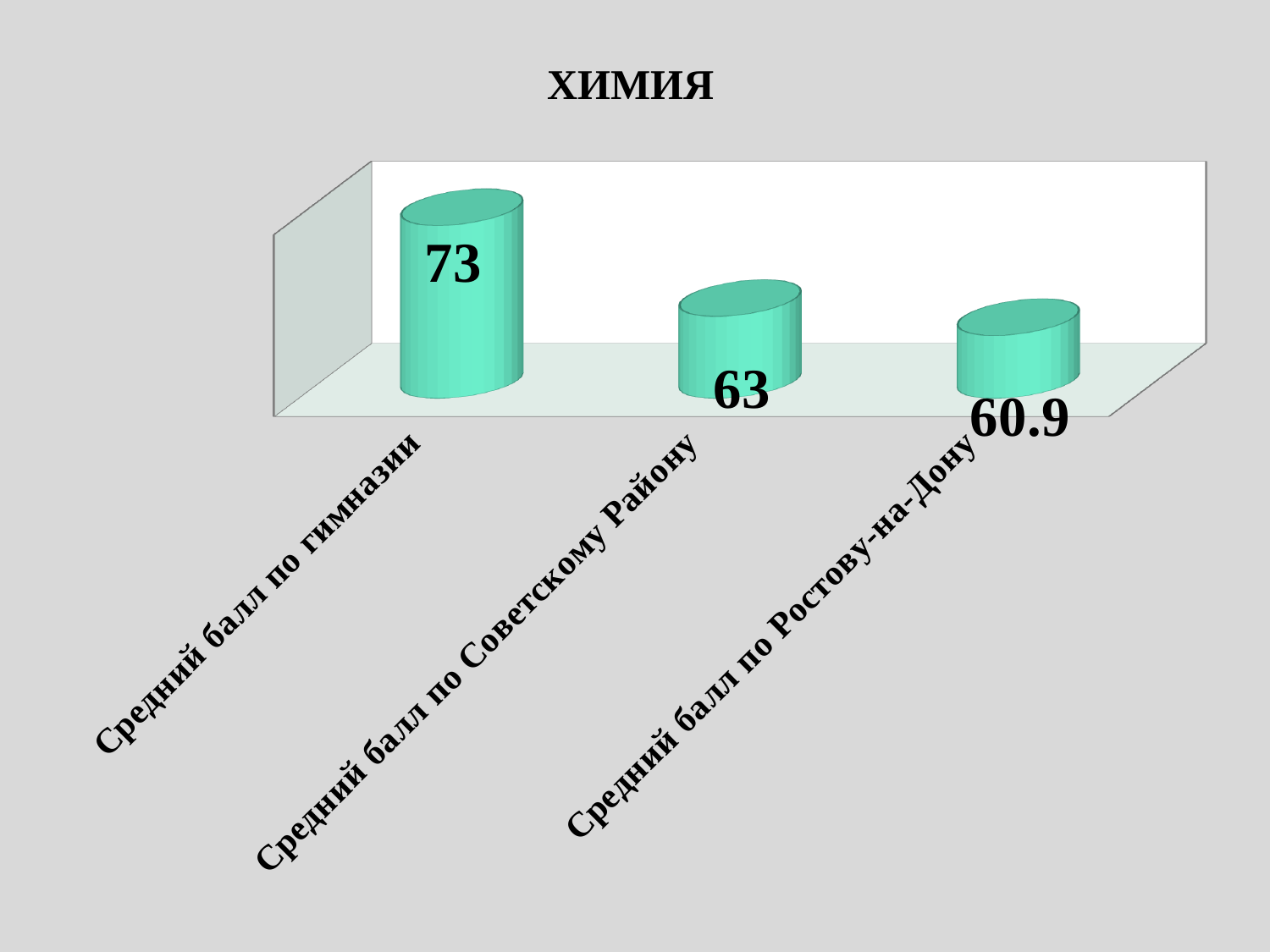
What is the difference between the gymnasium's average score and the Rostov-on-Don average score? 12.1 What is the average score for the gymnasium (Средний балл по гимназии)? 73 Which category has the lowest average score? Средний балл по Ростову-на-Дону Do the values rise or fall from left to right across the categories? Fall What is the average score for Sovetsky District (Средний балл по Советскому Району)? 63 What is the average score for Rostov-on-Don (Средний балл по Ростову-на-Дону)? 60.9 What is the difference between the gymnasium's average score and the Sovetsky District's average score? 10 What is the title of the chart? ХИМИЯ Which is larger: the average score for Sovetsky District or for Rostov-on-Don? Средний балл по Советскому Району Which category has the highest average score? Средний балл по гимназии What kind of chart is shown on the slide? Bar chart How many categories are shown in the chart? 3